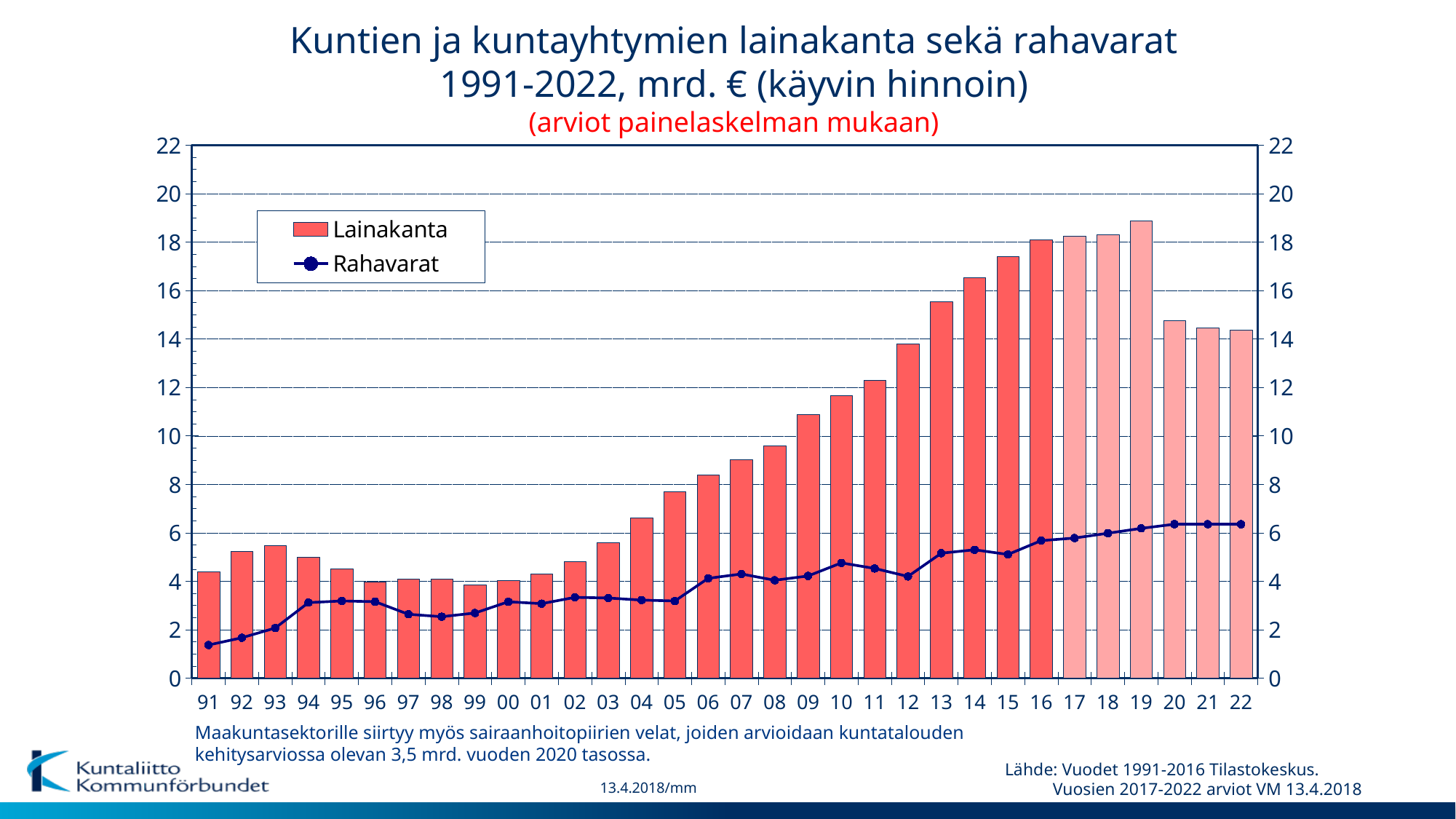
Is the Lainakanta value for 19 greater or less than 18? greater What kind of chart is shown on the slide? A bar chart combined with a line chart In which year is the Rahavarat value lowest? 91 Is the Rahavarat value for 12 greater or less than 6? less What are the two series named in the legend? Lainakanta and Rahavarat Is the Lainakanta value for 04 greater or less than 8? less In which year is the Lainakanta bar highest? 19 How many years are shown on the x axis? 32 Does the Lainakanta series rise or fall from 05 to 16? rise Does the Lainakanta series rise or fall from 19 to 22? fall Which is larger, the Lainakanta value for 19 or for 20? 19 How many series does the legend list? 2